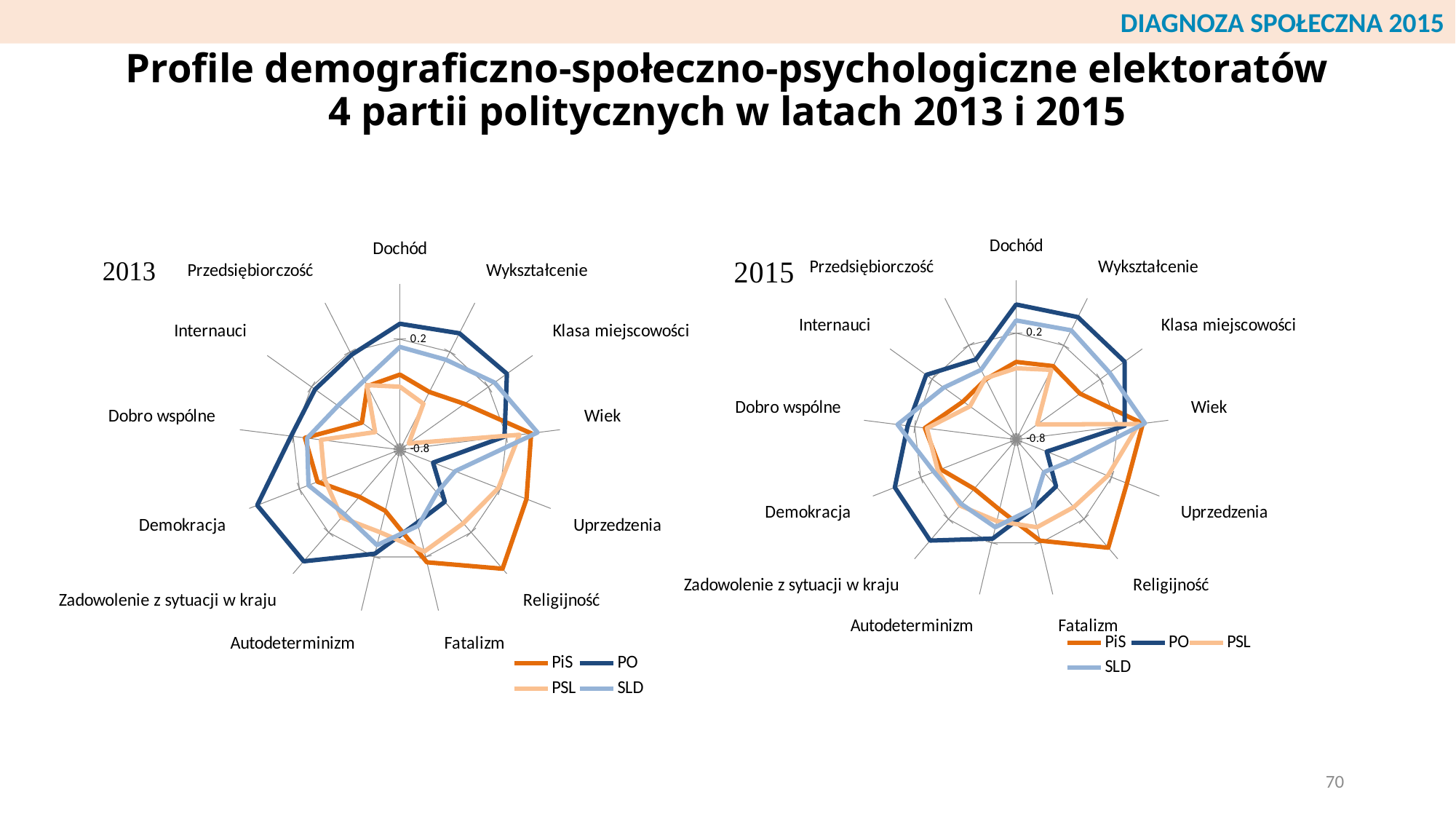
How many categories (axes) does the 2013 radar chart have? 13 In the 2013 chart, which is larger for Dochód: PO or PiS? PO In the 2013 chart, which party has the highest value for Religijność? PiS How many series does the legend of the 2015 chart list? 4 In the 2015 chart, which party has the lowest value for Religijność? SLD In the 2015 chart, which party has the highest value for Demokracja? PO In the 2015 chart, which is larger for Uprzedzenia: PiS or PO? PiS In the 2013 chart, which party has the lowest value for Religijność? SLD In the 2013 chart, which party has the highest value for Demokracja? PO What kind of chart is the 2013 chart on the left? radar chart Which parties are listed in the legend of the 2013 chart? PiS, PO, PSL, SLD